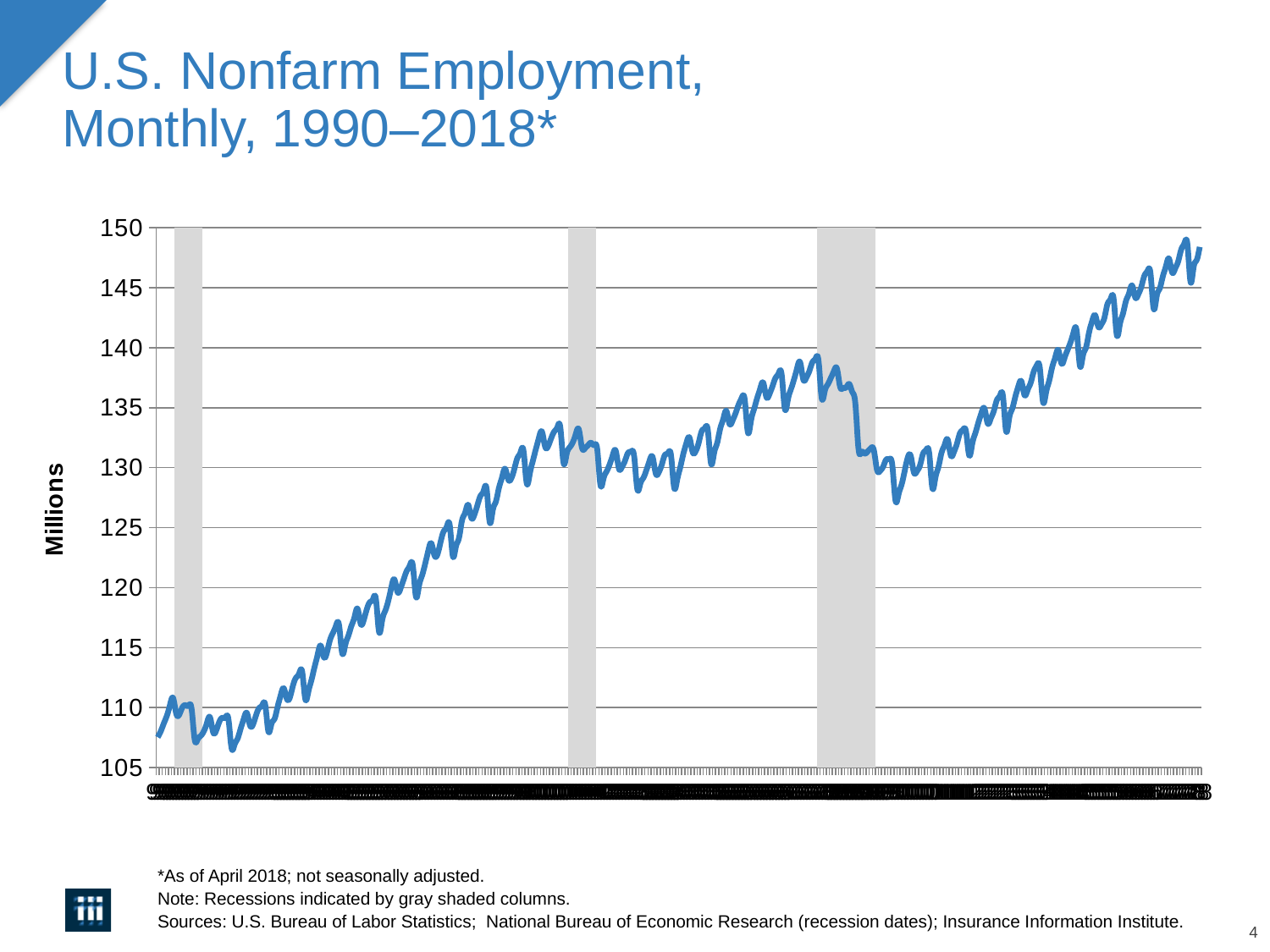
What is the label on the vertical axis? Millions Is the value at the leftmost point of the line greater or less than 110? less What kind of chart is shown on the slide? Line chart What is the title of the chart? U.S. Nonfarm Employment, Monthly, 1990–2018* Overall, does the line rise or fall from the left of the chart to the right? Rise Is the peak of the line just before the third gray shaded column greater or less than 140? less Is the value at the rightmost point of the line greater or less than 145? greater Does the line fall or rise during the third gray shaded column? Fall What is the highest value shown on the vertical axis? 150 Is the value at the rightmost point of the line larger or smaller than the value at the leftmost point? larger